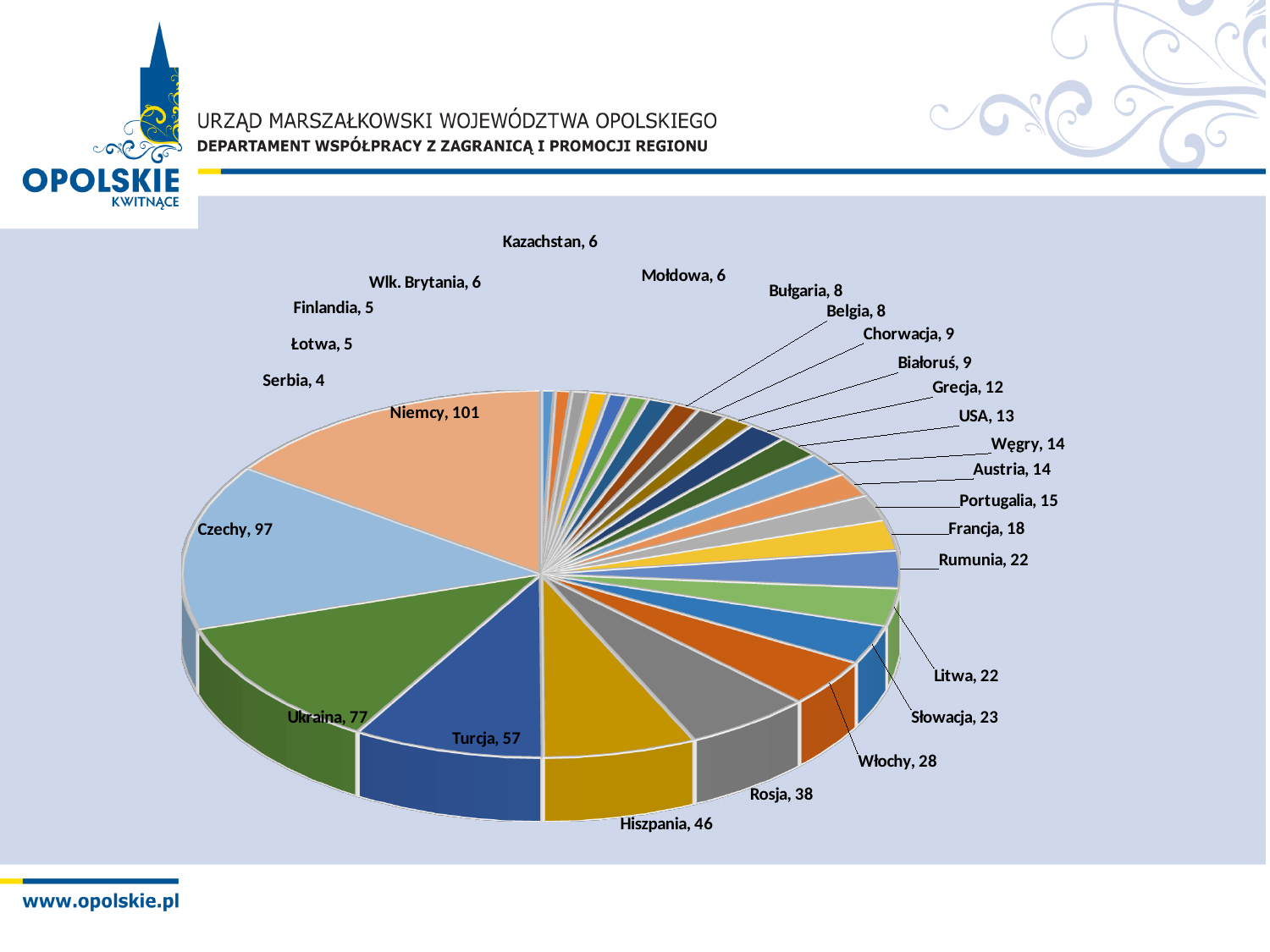
Which is larger, the value for Rosja or the value for Włochy? Rosja What is the difference between the values for Niemcy and Czechy? 4 What is the difference between the values for Ukraina and Turcja? 20 Which country has the smallest slice in the pie chart? Serbia What is the value for Słowacja in the pie chart? 23 What kind of chart is shown on the slide? pie chart Which country has the largest slice in the pie chart? Niemcy What is the value for Niemcy in the pie chart? 101 What is the value for Hiszpania in the pie chart? 46 Which is larger, the value for Francja or the value for Rumunia? Rumunia How many countries are shown in the pie chart? 26 What is the value for Portugalia in the pie chart? 15